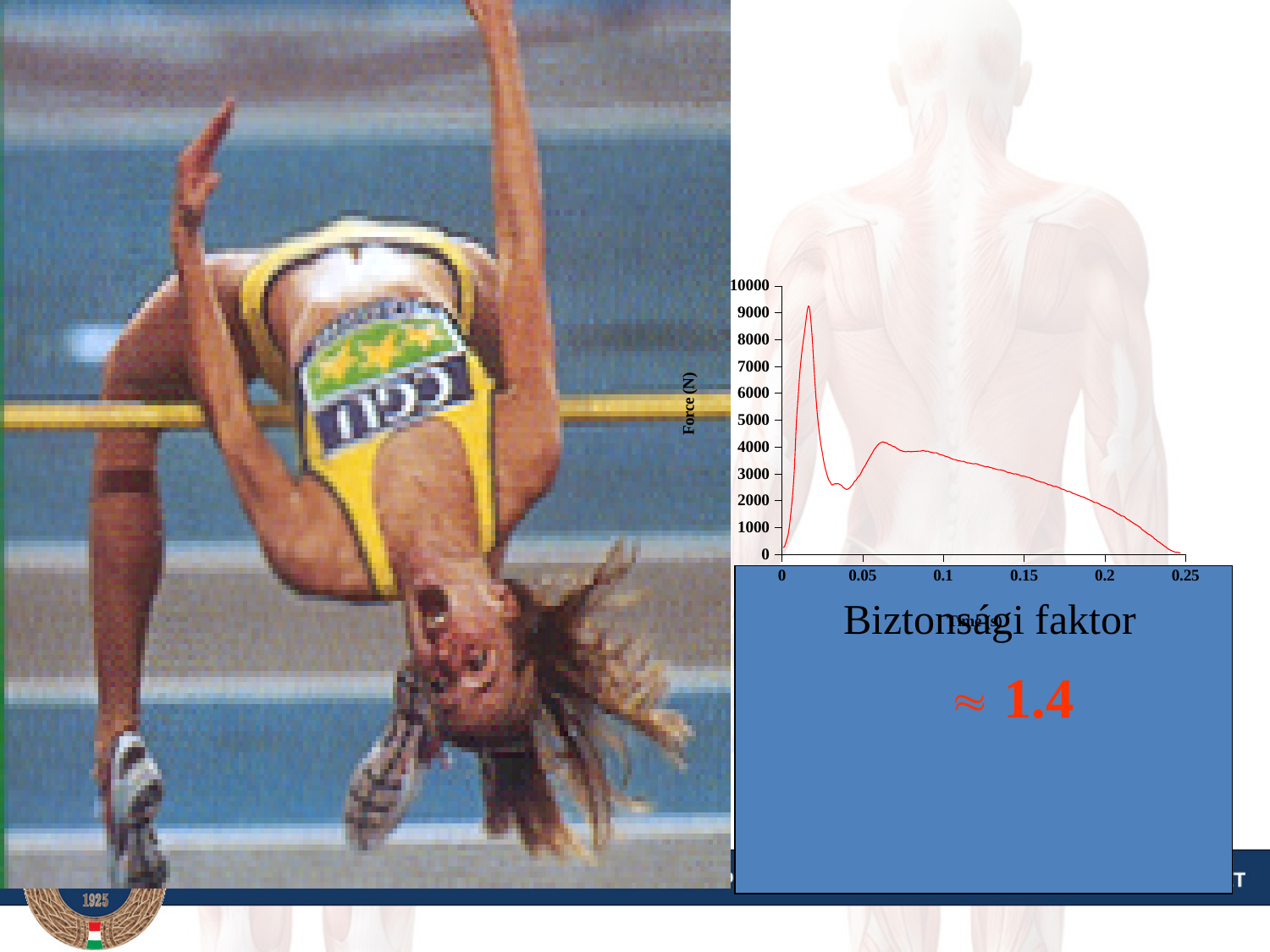
Is the force value at time 0.15 greater or less than 2000? greater How many tick labels are shown on the horizontal axis of the chart? 6 What is the colour of the plotted line in the chart? red What kind of chart is shown on the right side of the slide? line chart How many data series are plotted in the chart? 1 Is the force value at time 0.1 greater or less than 5000? less Is the peak force value in the chart greater or less than 8000? greater What is the highest value shown on the vertical axis of the chart? 10000 Does the force rise or fall between time 0.1 and time 0.2? fall What is the label of the vertical axis of the chart? Force (N) Is the force at time 0.05 larger or smaller than the force at time 0.2? larger